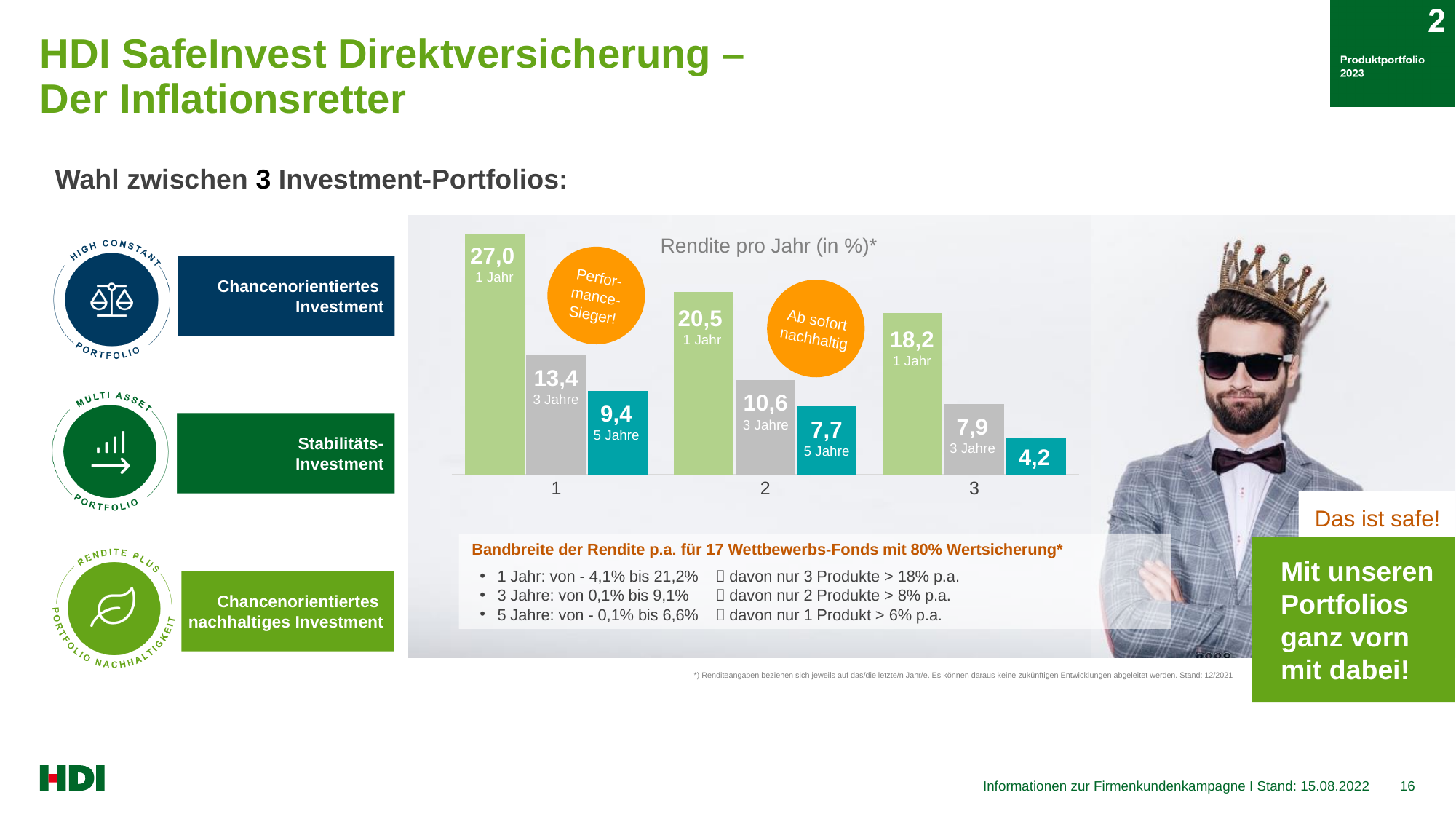
What kind of chart is shown under the title "Rendite pro Jahr (in %)*"? bar chart What is the 3 Jahre value for group 2 in the "Rendite pro Jahr" chart? 10,6 What is the 1 Jahr value for group 3 in the "Rendite pro Jahr" chart? 18,2 In the "Rendite pro Jahr" chart, do the values within group 1 rise or fall from 1 Jahr to 5 Jahre? fall What is the 5 Jahre value for group 1 in the "Rendite pro Jahr" chart? 9,4 In the "Rendite pro Jahr" chart, what is the difference between the 1 Jahr and 3 Jahre values for group 1? 13,6 How many groups of bars are shown on the x axis of the "Rendite pro Jahr" chart? 3 What is the 1 Jahr value for group 1 in the "Rendite pro Jahr" chart? 27,0 Which bar has the highest value in the "Rendite pro Jahr" chart? 1 Jahr in group 1 (27,0) In the "Rendite pro Jahr" chart, which is larger: the 3 Jahre value for group 1 or the 3 Jahre value for group 2? group 1 (13,4) Which bar has the lowest value in the "Rendite pro Jahr" chart? the teal bar in group 3 (4,2) In the "Rendite pro Jahr" chart, what is the difference between the 1 Jahr values of group 2 and group 3? 2,3